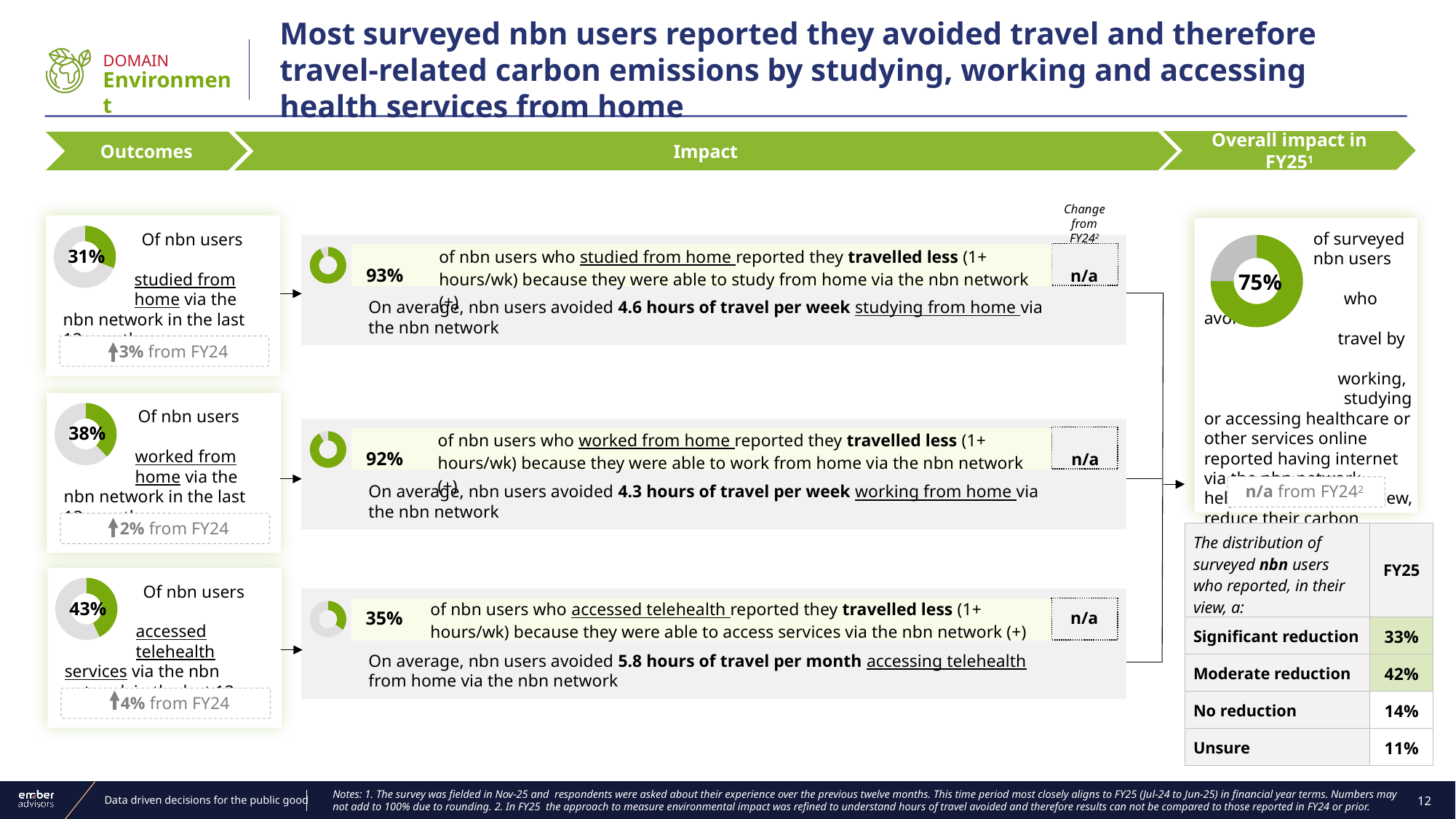
What percentage is shown in the donut chart for nbn users who studied from home via the nbn network? 31% Among the three donut charts in the Outcomes column, which activity has the lowest percentage of nbn users? Studied from home Among the three donut charts in the Outcomes column, which activity has the highest percentage of nbn users? Accessed telehealth services In the Outcomes donut charts, which is larger: the percentage of nbn users who worked from home or the percentage who studied from home? Worked from home What percentage is shown in the donut chart for nbn users who accessed telehealth services via the nbn network? 43% In the Impact column, what percentage of nbn users who accessed telehealth reported they travelled less, as shown next to the small donut chart? 35% In the Impact column, which is larger: the percentage of nbn users who studied from home and travelled less, or the percentage who accessed telehealth and travelled less? Studied from home (93%) What is the difference between the percentage of nbn users who accessed telehealth services and the percentage who studied from home, as shown in the Outcomes donut charts? 12% What kind of chart is used to show the percentages in the Outcomes column? Donut chart What percentage is shown in the donut chart for nbn users who worked from home via the nbn network? 38% What percentage is shown in the donut chart under 'Overall impact in FY25' on the right of the slide? 75% How many donut charts are shown in the Outcomes column on the left of the slide? 3